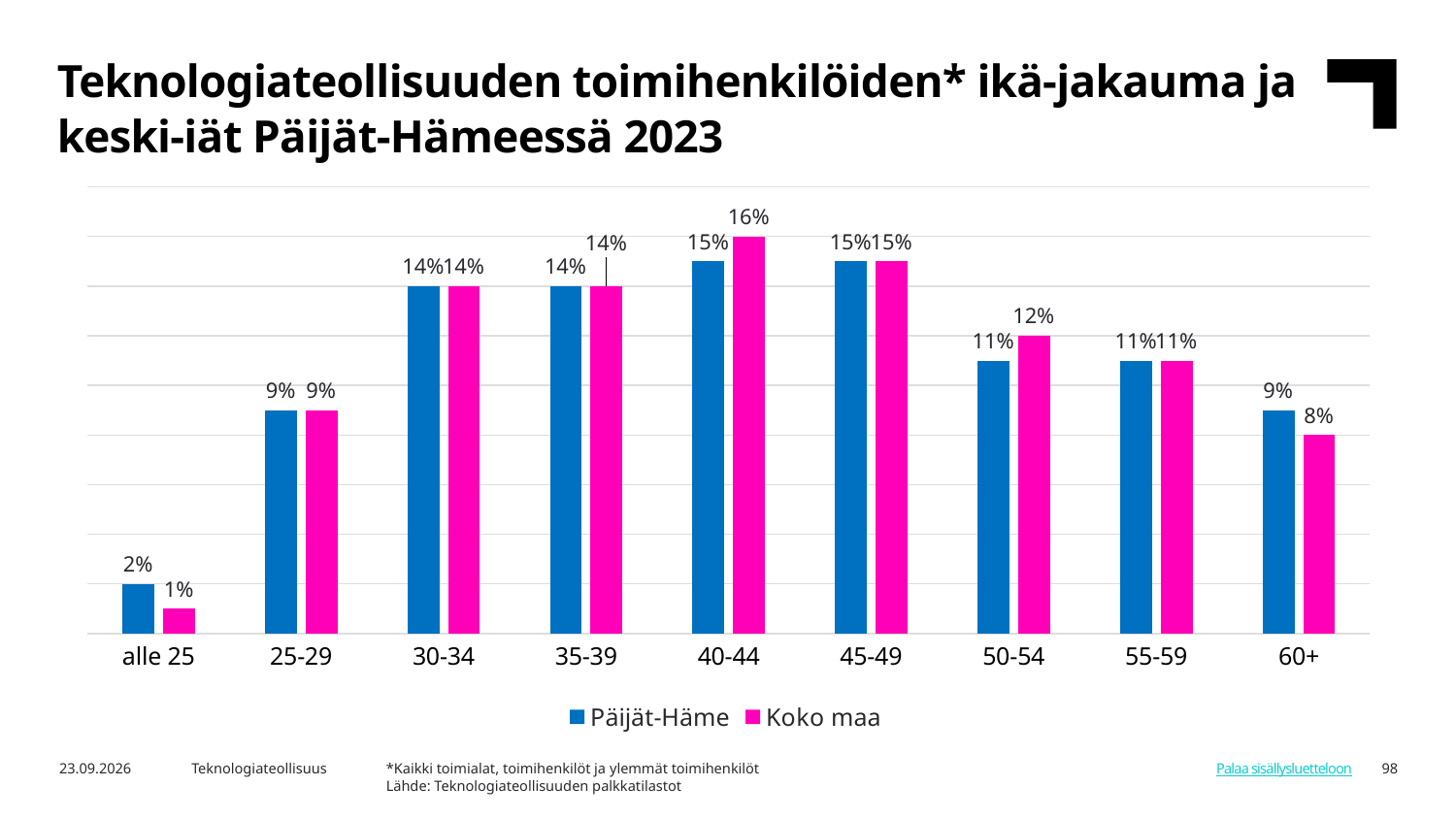
How many age categories are shown on the x axis? 9 What is the difference between the Koko maa and Päijät-Häme values in the 60+ age group? 1% What is the value for Päijät-Häme in the alle 25 age group? 2% What is the value for Koko maa in the 40-44 age group? 16% What is the value for Päijät-Häme in the 50-54 age group? 11% What kind of chart is shown on the slide? bar chart Which series is shown in pink? Koko maa What is the value for Koko maa in the 55-59 age group? 11% How many series does the legend list? 2 Which age group has the highest value for Koko maa? 40-44 Which age group has the lowest value for Päijät-Häme? alle 25 In the 50-54 age group, which series has the larger value, Päijät-Häme or Koko maa? Koko maa